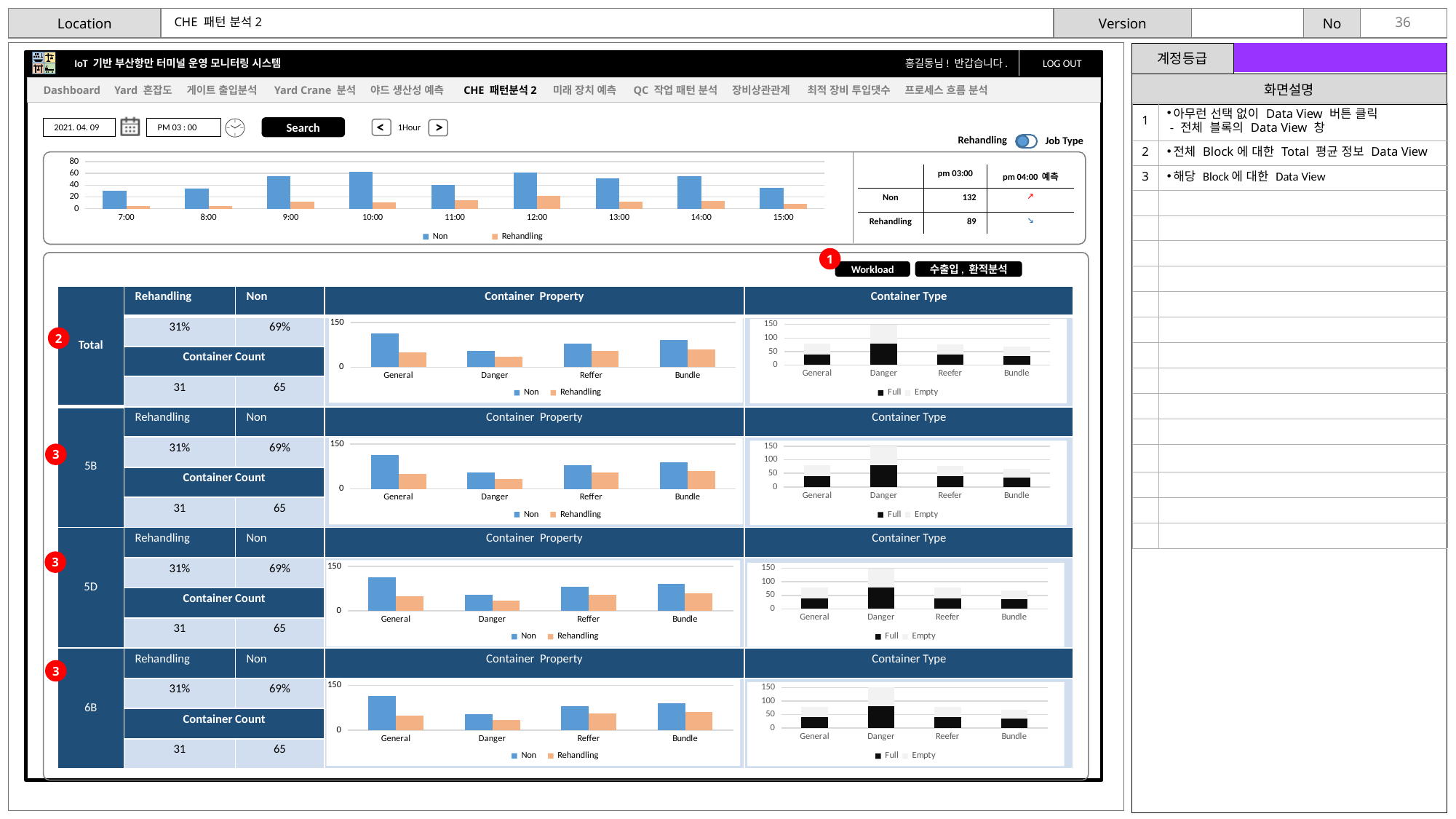
In the Total row's Container Type chart, is the Full value for General greater or less than 50? less In the Total row's Container Property chart, what are the two series listed in the legend? Non, Rehandling In the Total row's Container Type chart, which category has the highest Full value? Danger In the top hourly chart, is the Non value at 10:00 greater or less than 40? greater In the Total row's Container Type chart, is the Empty value for Danger greater or less than 100? less In the top hourly chart, which is larger at 9:00, Non or Rehandling? Non In the Total row's Container Property chart, which category has the highest Non value? General In the top hourly chart, how many time categories are shown on the x axis? 9 In the top hourly chart, how many series does the legend list? 2 What kind of chart is the top hourly chart? bar chart In the Total row's Container Property chart, which category has the lowest Non value? Danger